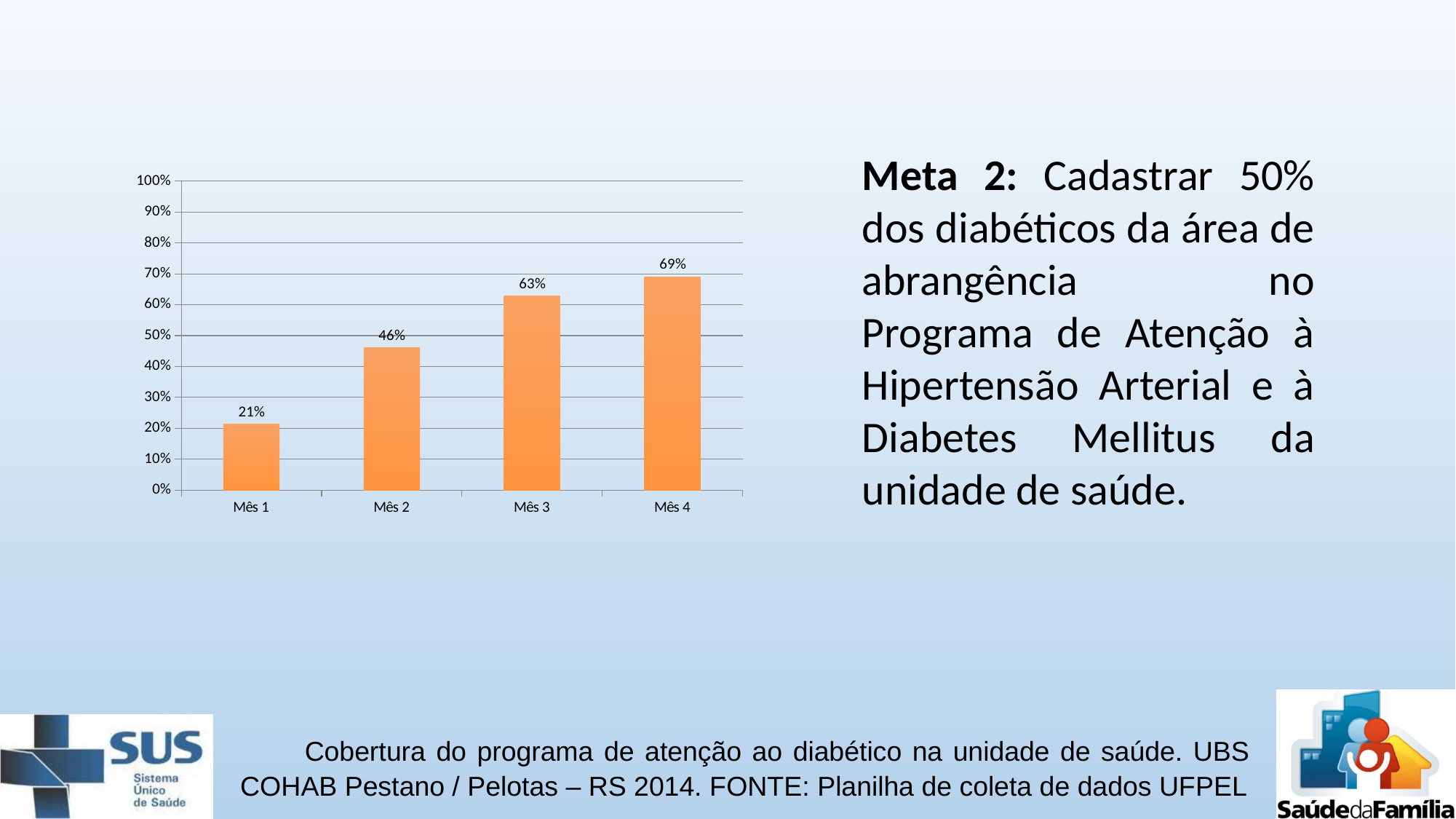
What is the value for Mês 4? 69% Which month has the lowest value? Mês 1 What is the value for Mês 3? 63% What is the value for Mês 2? 46% What kind of chart is shown on the slide? bar chart What is the value for Mês 1? 21% Is the value for Mês 2 greater or less than 50%? less How many months are shown on the x axis? 4 What is the difference between the values for Mês 3 and Mês 2? 17% Which month has the highest value? Mês 4 Which is larger, the value for Mês 2 or the value for Mês 3? Mês 3 What is the difference between the values for Mês 4 and Mês 1? 48%